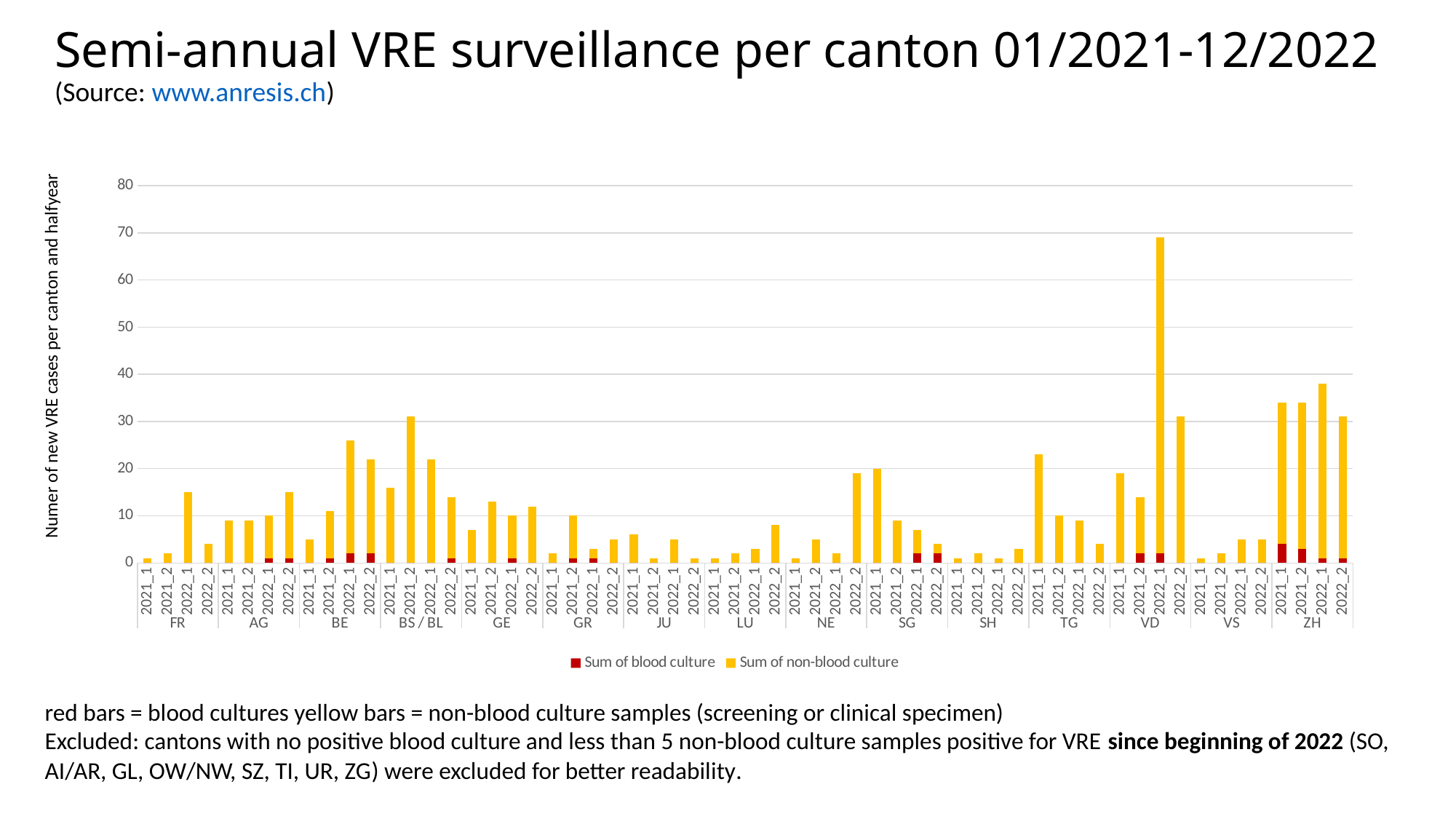
How many series does the legend list? 2 Is the total for VD in 2022_1 greater or less than 60? greater Which colour represents the 'Sum of blood culture' series? Red How many half-year periods are plotted for each canton? 4 Is the total for ZH in 2022_1 greater or less than 30? greater What are the two series named in the legend? Sum of blood culture; Sum of non-blood culture How many cantons are shown along the x axis? 15 Is the total for FR in 2022_1 greater or less than 10? greater What kind of chart is shown on the slide? Stacked bar chart Which canton and half-year has the highest total bar? VD, 2022_1 Which is larger, the total for VD in 2022_1 or the total for ZH in 2022_1? VD in 2022_1